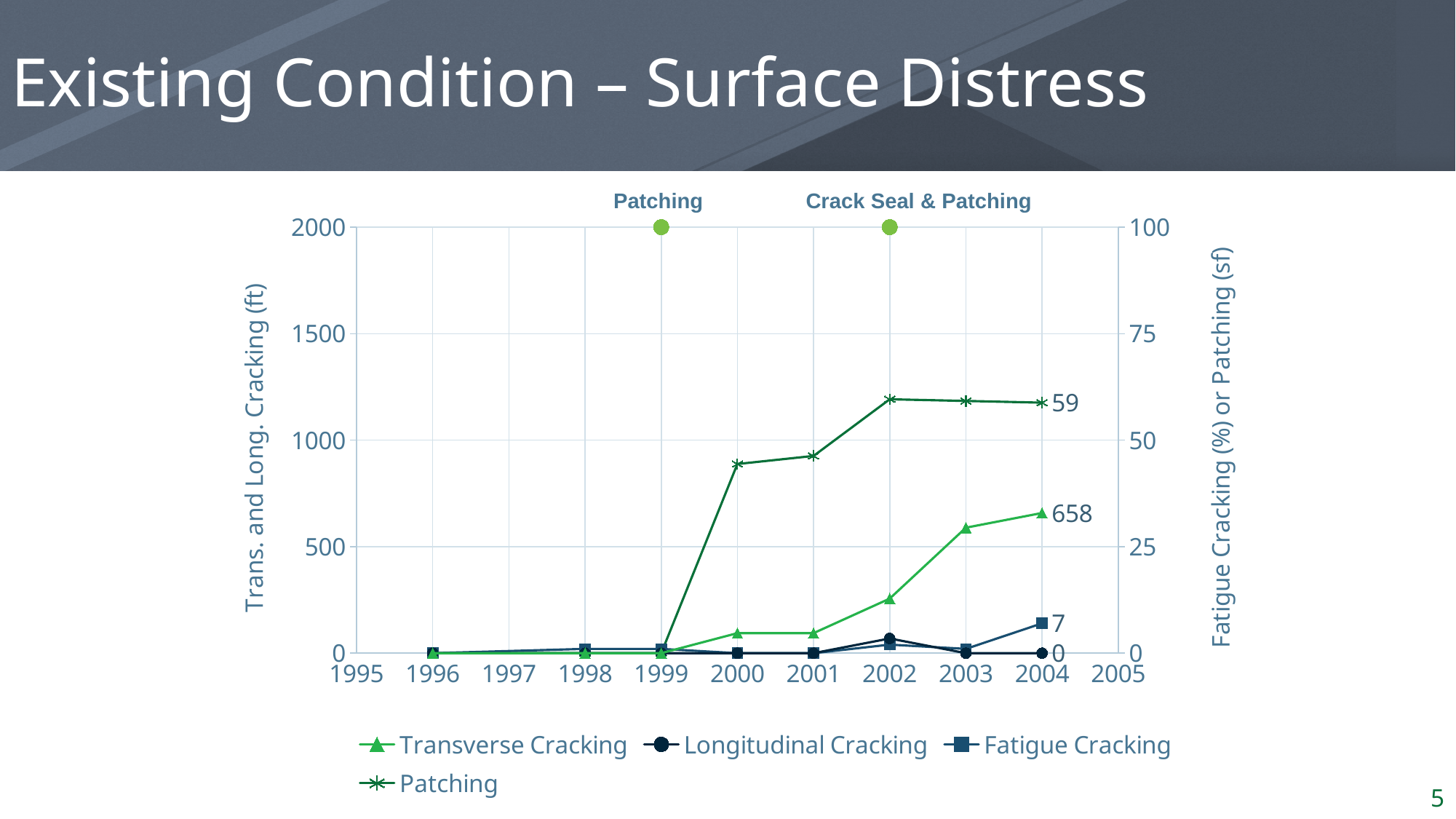
Does Transverse Cracking rise or fall from 1996 to 2004? rise Is the value for Transverse Cracking in 2003 greater or less than 500? greater How many series does the legend list? 4 What is the value of Longitudinal Cracking in 2004? 0 What is the value of Patching in 2004? 59 What kind of chart is shown on the slide? line chart In which year is Transverse Cracking highest? 2004 Is the value for Transverse Cracking in 2000 greater or less than 500? less What is the value of Transverse Cracking in 2004? 658 Which is larger, Transverse Cracking in 2003 or in 2004? 2004 What is the value of Fatigue Cracking in 2004? 7 What is the title of the right-hand vertical axis? Fatigue Cracking (%) or Patching (sf)